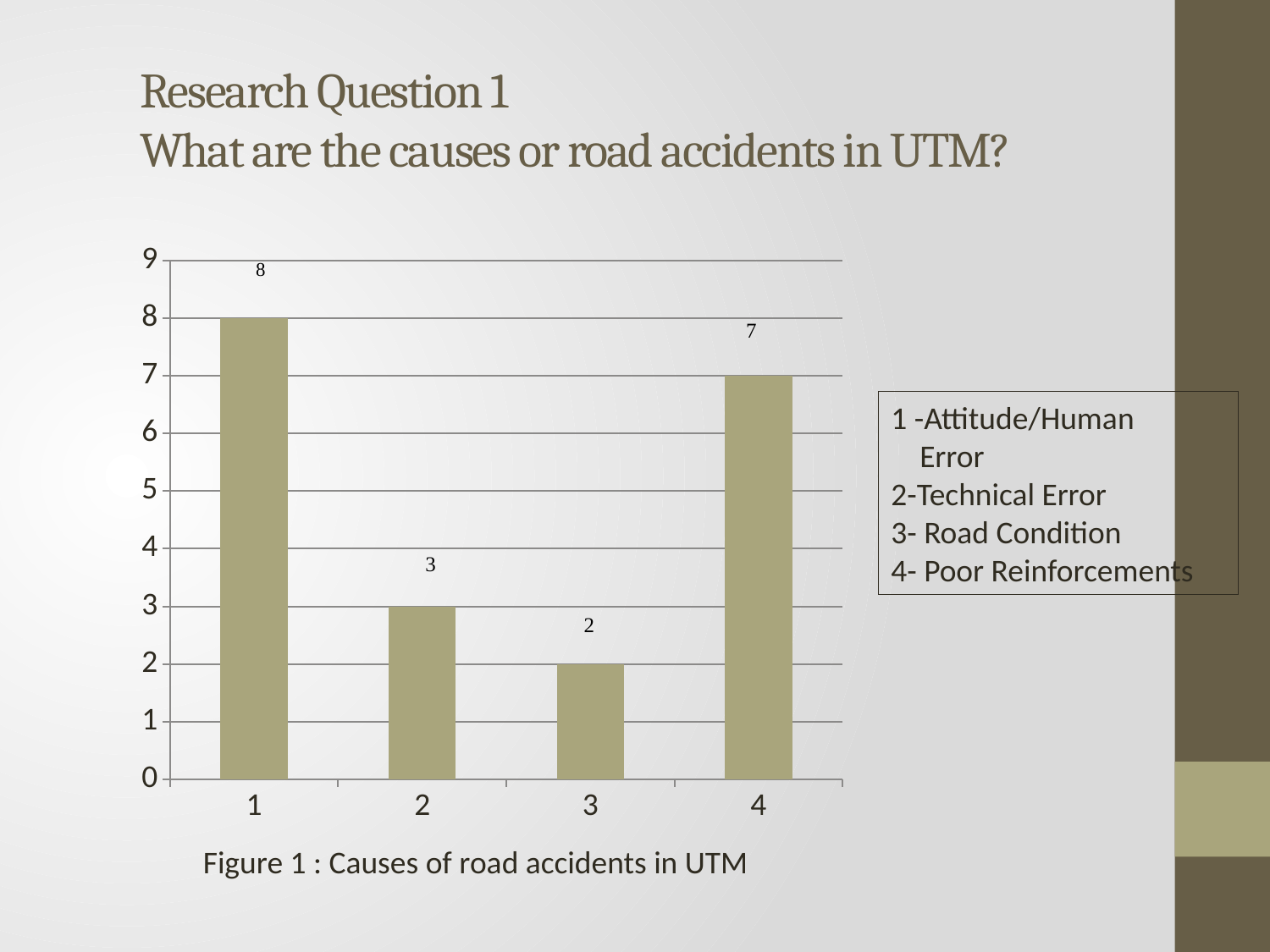
What is the difference between the values for category 1 and category 4? 1 What is the value for category 1 (Attitude/Human Error)? 8 What is the value for category 4 (Poor Reinforcements)? 7 What is the figure caption below the chart? Figure 1 : Causes of road accidents in UTM Which category has the lowest value? 3 What is the value for category 2 (Technical Error)? 3 What is the value for category 3 (Road Condition)? 2 Which category has the highest value? 1 What is the difference between the values for category 2 and category 3? 1 Which is larger, the value for category 2 or the value for category 4? 4 What kind of chart is shown on the slide? Bar chart How many categories are shown on the x axis? 4